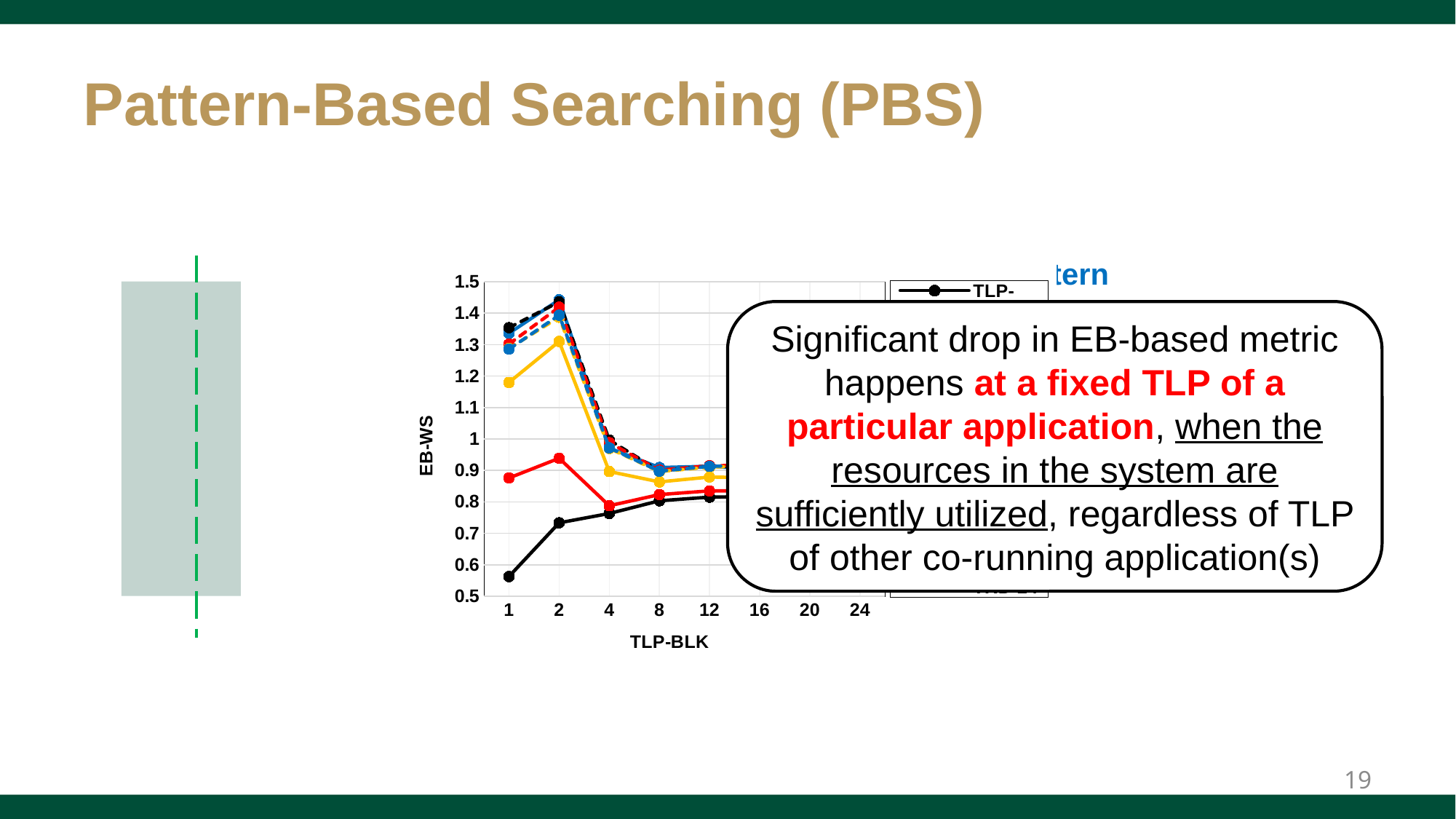
What is the label of the y axis of the chart? EB-WS What is the label of the x axis of the chart? TLP-BLK What is the lowest value shown on the y axis of the chart? 0.5 Does the solid black line rise or fall as TLP-BLK increases from 1 to 12? rise Is the value of the dashed black line at TLP-BLK 2 greater or less than 1.4? greater Is the value of the solid yellow line at TLP-BLK 1 greater or less than 1.1? greater Do the dashed lines rise or fall between TLP-BLK 2 and TLP-BLK 8? fall What kind of chart is shown on the slide? line chart Is the value of the solid black line at TLP-BLK 1 greater or less than 0.6? less How many tick values are shown on the x axis of the chart? 8 What is the highest value shown on the y axis of the chart? 1.5